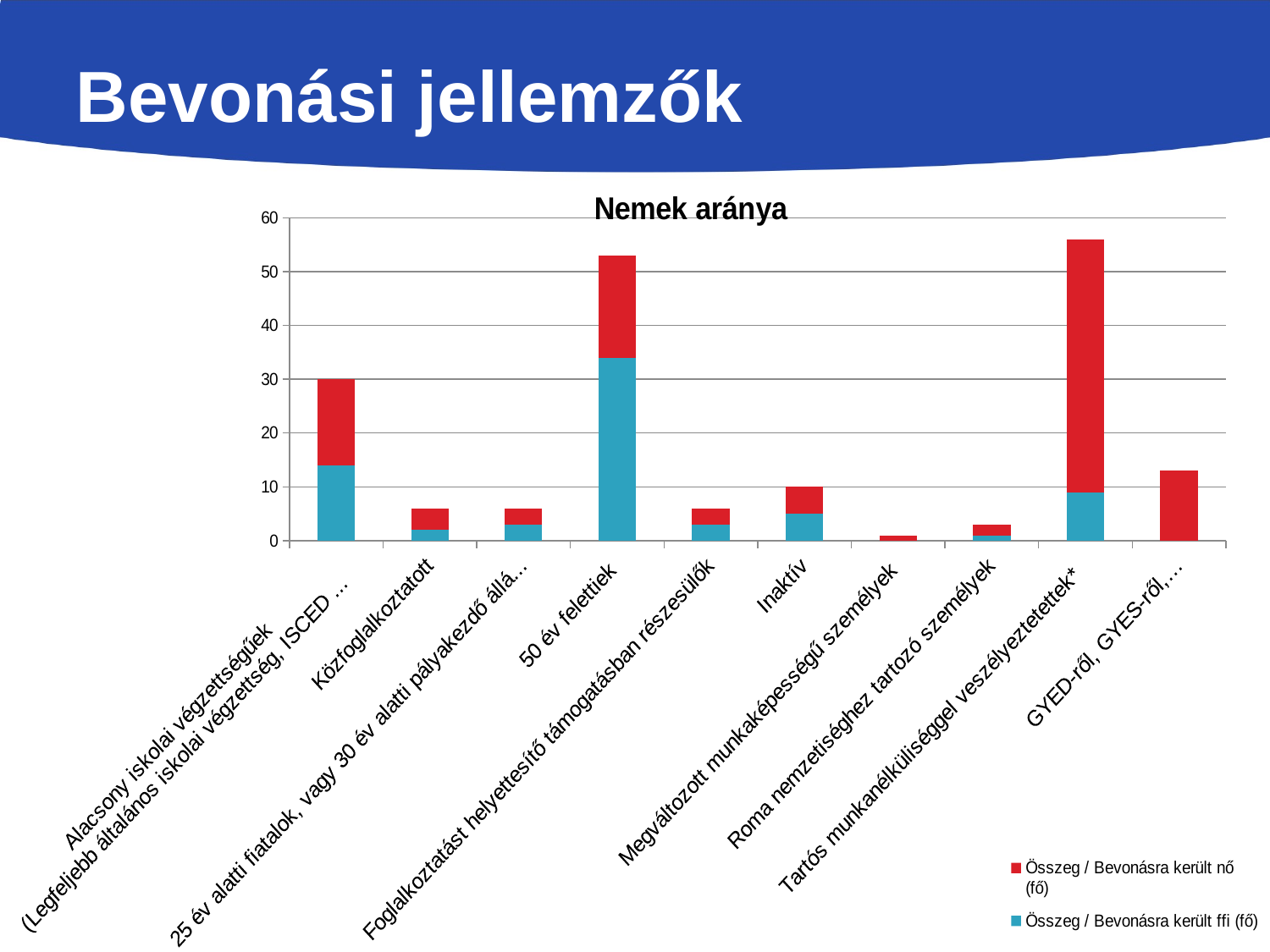
How many series does the legend list? 2 Which colour represents Összeg / Bevonásra került nő (fő) in the chart? red What is the title of the chart? Nemek aránya Is the total value for GYED-ről, GYES-ről,… greater or less than 10? greater Is the Összeg / Bevonásra került ffi (fő) value for 50 év felettiek greater or less than 30? greater Which category has the lowest total bar? Megváltozott munkaképességű személyek Which has the larger total bar: 50 év felettiek or Inaktív? 50 év felettiek Is the total value for Roma nemzetiséghez tartozó személyek greater or less than 10? less What kind of chart is shown on the slide? stacked bar chart Which category has the highest total bar? Tartós munkanélküliséggel veszélyeztetettek* How many categories are shown on the x axis? 10